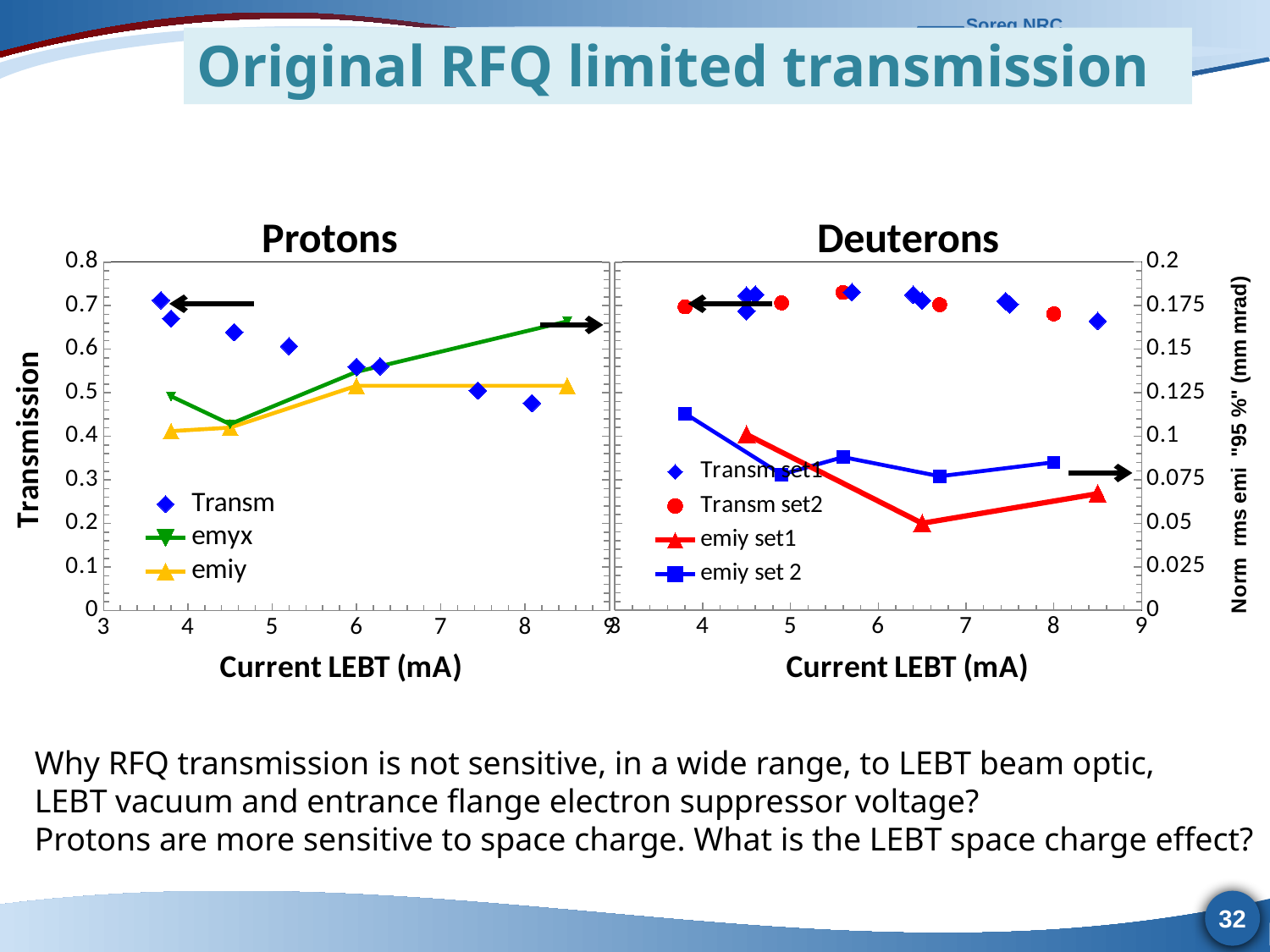
In the Protons chart, which is larger: the Transm value at about 4.5 mA or at about 8 mA? at about 4.5 mA How many series does the legend of the Protons chart list? 3 What is the left y-axis title of the Protons chart? Transmission What is the x-axis title of the Protons chart? Current LEBT (mA) In the Deuterons chart, at about 6.5 mA, which is larger: emiy set1 or emiy set 2? emiy set 2 In the Protons chart, is the Transm value at about 4.5 mA greater or less than 0.6? greater How many data points does the emiy set1 series have in the Deuterons chart? 3 In the Protons chart, does the Transm series rise or fall as Current LEBT increases? fall In the Protons chart, does the emyx series rise or fall overall from 4.5 mA to 8.5 mA? rise How many series does the legend of the Deuterons chart list? 4 In the Deuterons chart, is the Transm set1 value at about 8.5 mA greater or less than 0.7? less